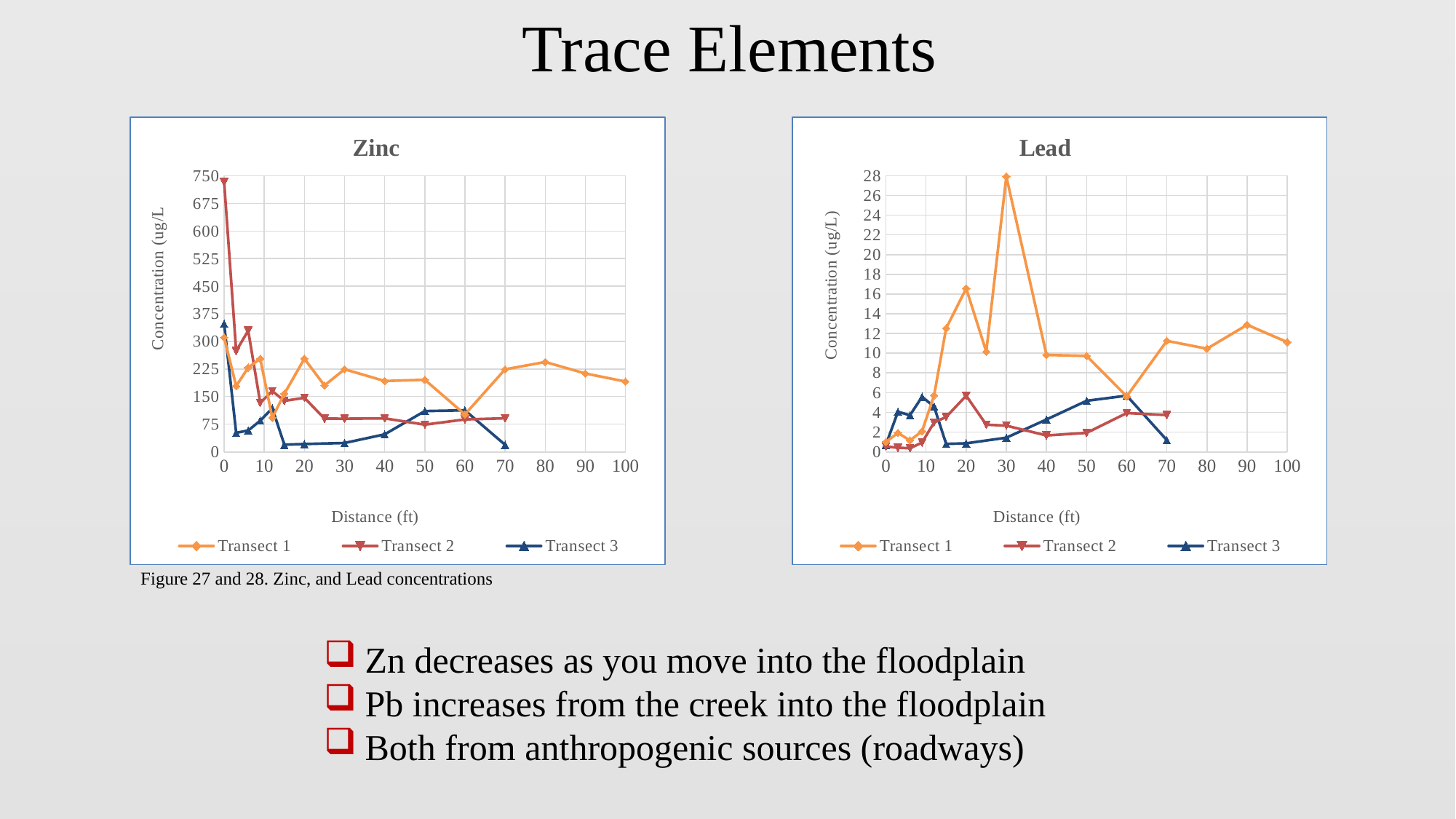
In the Lead chart, is the value for Transect 1 at distance 20 greater or less than 14? greater In the Zinc chart, is the value for Transect 2 at distance 0 greater or less than 600? greater How many series does the legend of the Lead chart list? 3 In the Lead chart, is the value for Transect 3 at distance 70 greater or less than 2? less What is the x-axis label of the Zinc chart? Distance (ft) In the Zinc chart, which series reaches the highest concentration? Transect 2 What kind of chart is the Zinc chart? line chart In the Lead chart, at distance 30, which is larger: Transect 1 or Transect 2? Transect 1 In the Lead chart, which series reaches the highest concentration? Transect 1